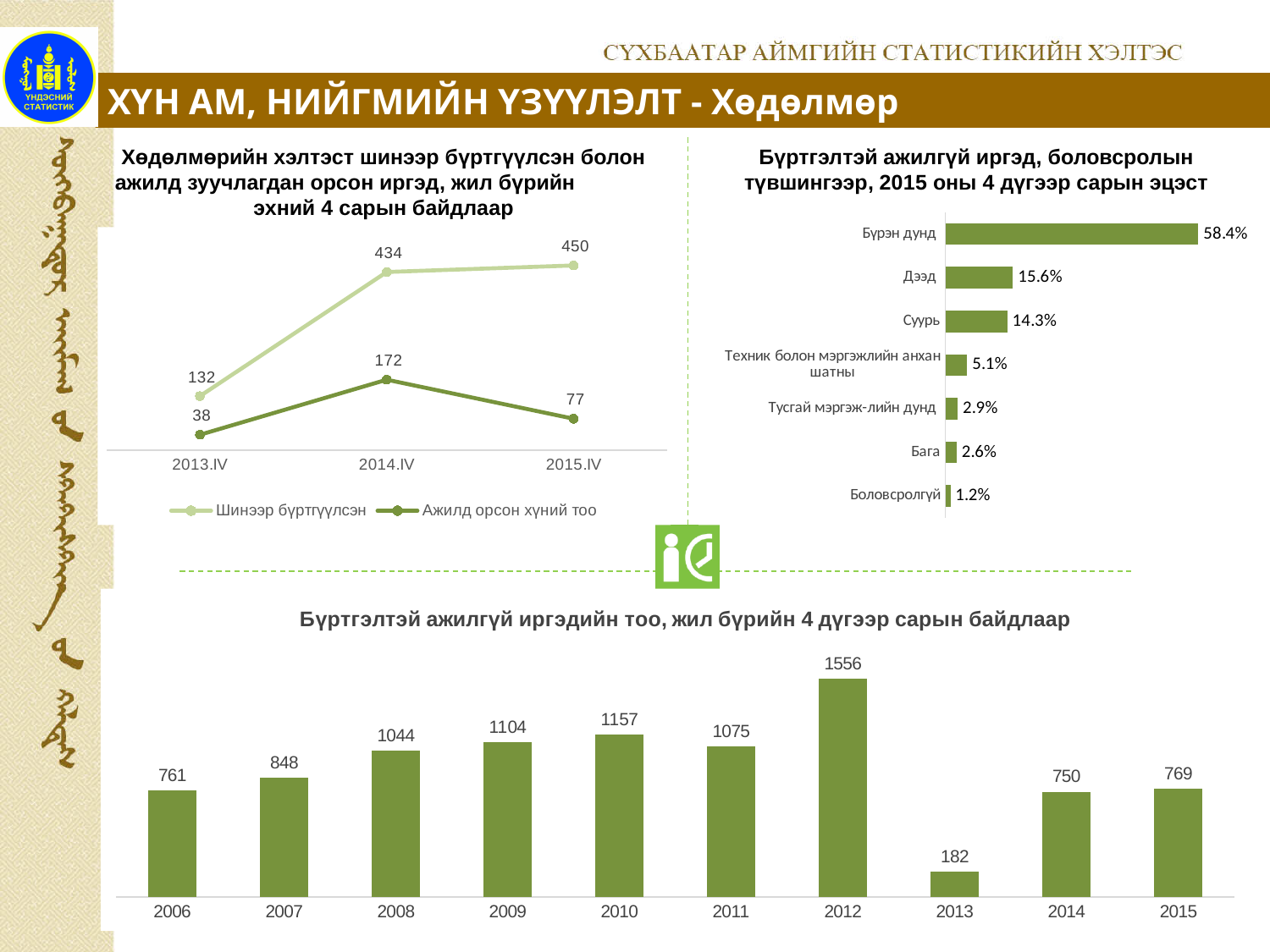
In the top-left line chart, how many series does the legend list? 2 In the top-right bar chart, what is the value for 'Дээд'? 15.6% In the bottom chart, which year has the lowest value? 2013 In the top-left line chart, what is the difference between 'Шинээр бүртгүүлсэн' and 'Ажилд орсон хүний тоо' in 2013.IV? 94 In the bottom chart, what is the value for 2012? 1556 In the top-right bar chart, how many categories are shown? 7 In the bottom chart, what is the difference between the values for 2010 and 2011? 82 In the top-left line chart, what is the value of 'Шинээр бүртгүүлсэн' for 2014.IV? 434 In the top-left line chart, what is the value of 'Ажилд орсон хүний тоо' for 2015.IV? 77 In the top-right bar chart, which category has the lowest value? Боловсролгүй In the top-right bar chart, which category has the highest value? Бүрэн дунд What kind of chart is the bottom chart? Bar chart